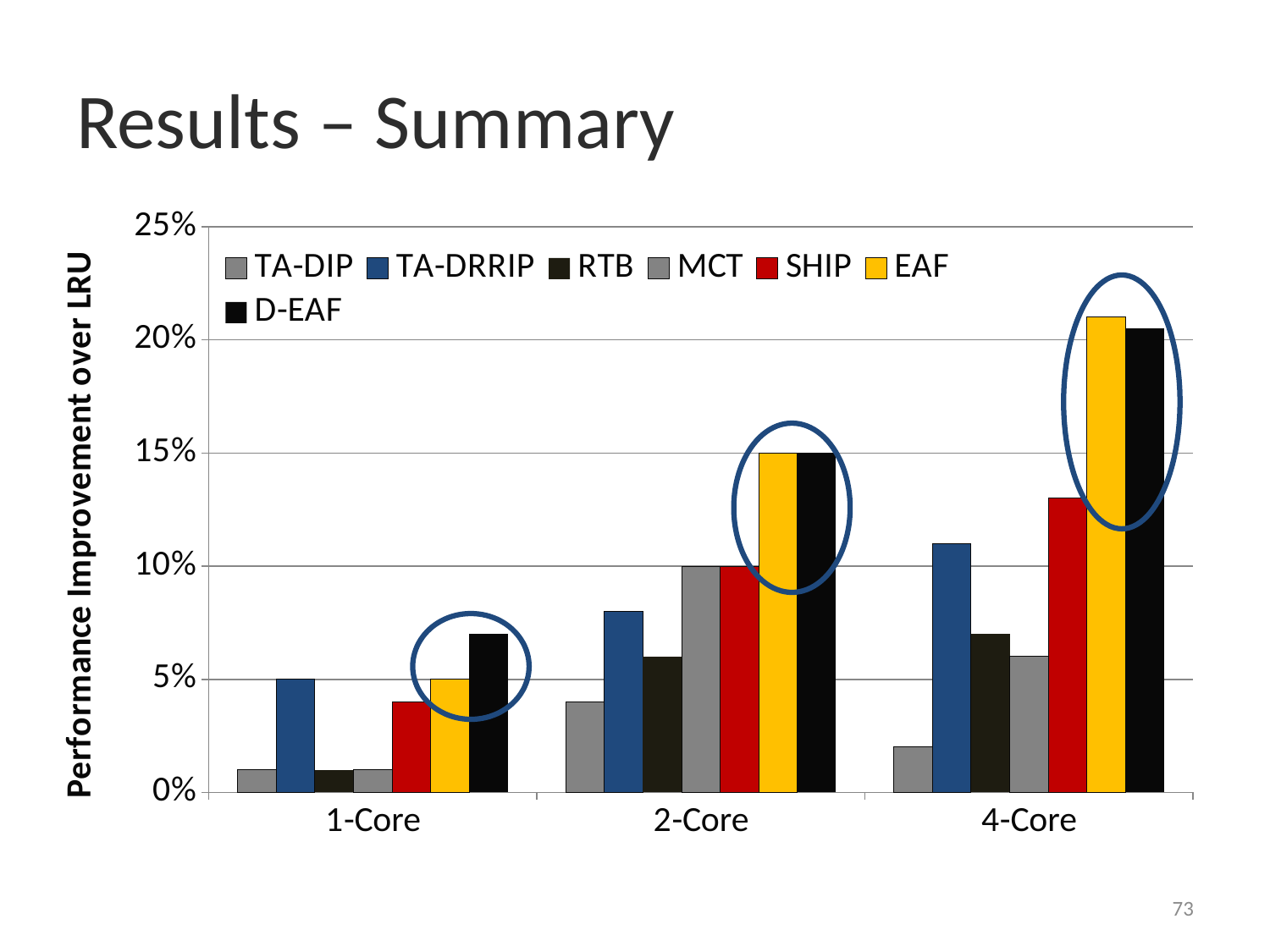
How many series does the legend list? 7 Is the value for TA-DRRIP in the 2-Core category greater or less than 10%? less What is the value for TA-DRRIP in the 1-Core category? 5% Do the EAF values rise or fall from 1-Core to 4-Core? rise Which is larger in the 4-Core category, TA-DRRIP or SHIP? SHIP How many categories are shown on the x axis? 3 Which series has the lowest value in the 4-Core category? TA-DIP What is the value for SHIP in the 2-Core category? 10% Is the value for SHIP in the 4-Core category greater or less than 15%? less What kind of chart is shown on the slide? bar chart Is the value for EAF in the 4-Core category greater or less than 20%? greater What is the value for EAF in the 2-Core category? 15%